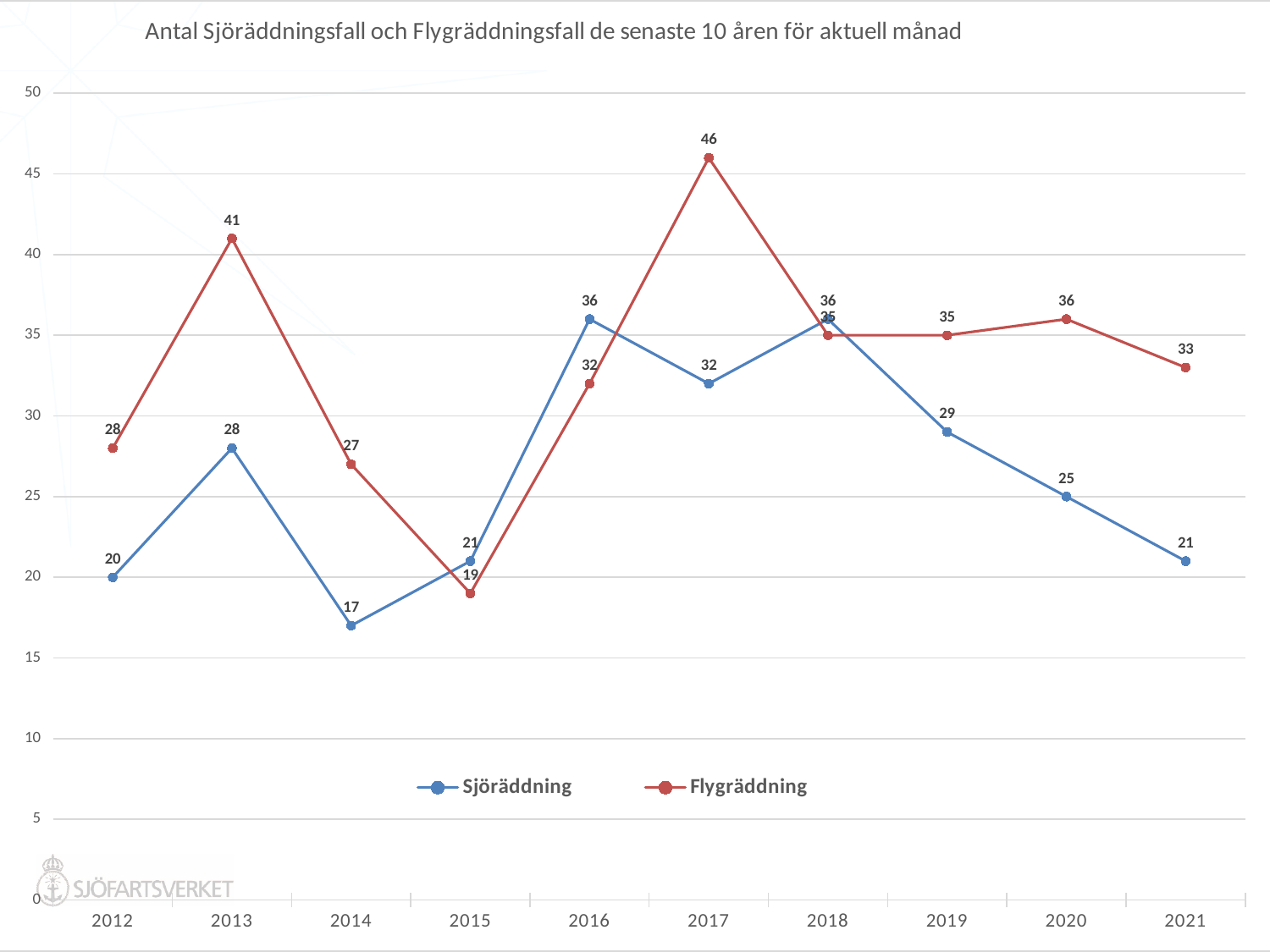
What colour is the Flygräddning line? red Does the Sjöräddning value rise or fall from 2018 to 2021? fall In which year is the Flygräddning value highest? 2017 What is the value for Flygräddning in 2017? 46 What is the difference between Flygräddning and Sjöräddning in 2013? 13 How many years are shown on the x axis? 10 What is the value for Sjöräddning in 2014? 17 How many series does the legend list? 2 Which series has the larger value in 2016, Sjöräddning or Flygräddning? Sjöräddning In which year is the Sjöräddning value lowest? 2014 What type of chart is shown on the slide? line chart What is the value for Sjöräddning in 2021? 21